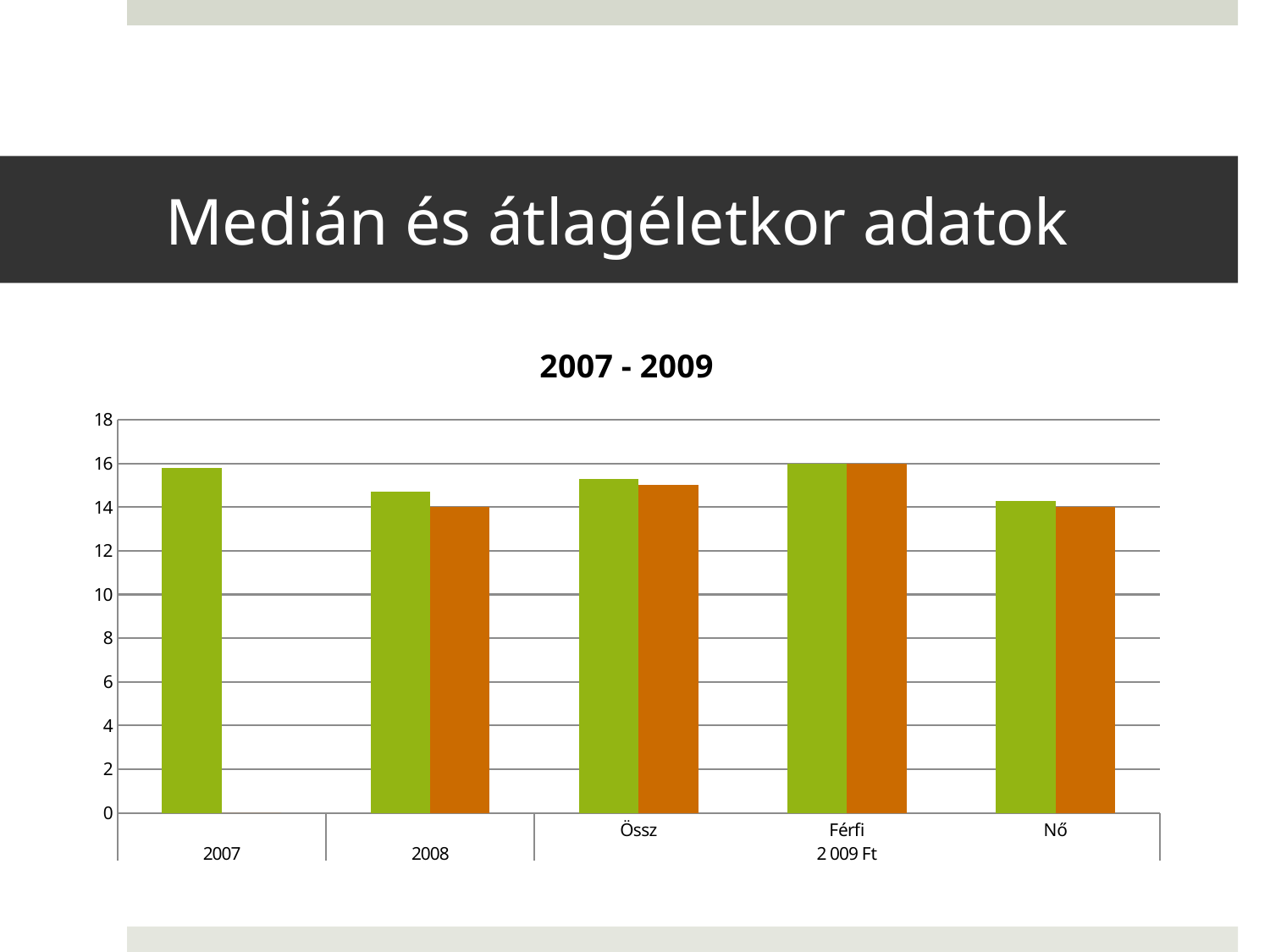
What value does the orange bar for Férfi reach on the axis? 16 What is the title of the chart? 2007 - 2009 Is the green bar for Nő greater or less than 16? less Which has the taller green bar, 2007 or 2008? 2007 How many categories are shown along the x axis of the chart? 5 Is the green bar for 2008 greater or less than 16? less What kind of chart is shown on the slide? bar chart How many bars are shown for the 2007 category? 1 Is the green bar for Férfi greater or less than 12? greater Which has the taller green bar, Össz or Nő? Össz